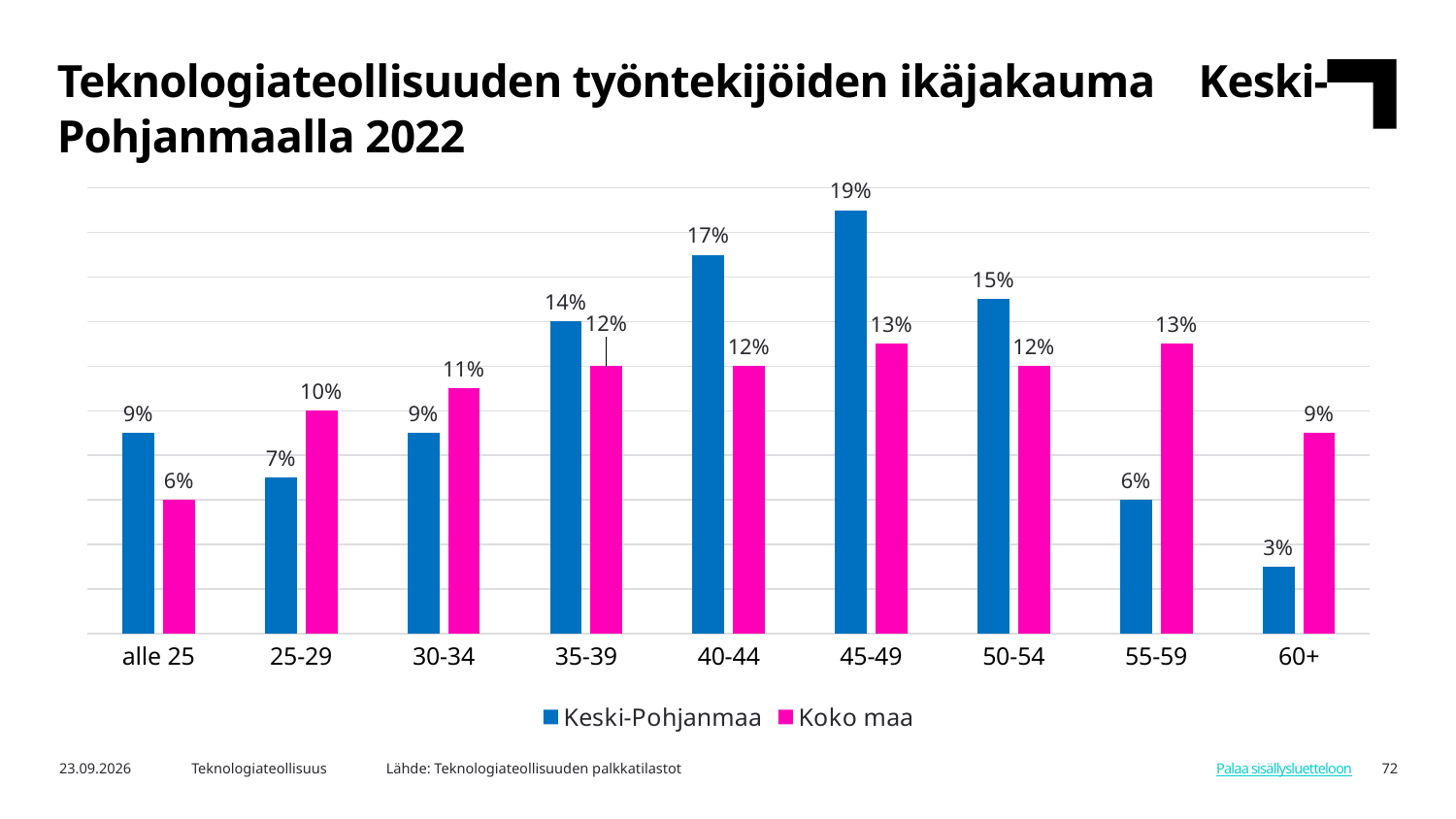
Which colour represents the Koko maa series? pink Which is larger for the 55-59 age group, Keski-Pohjanmaa or Koko maa? Koko maa What is the Keski-Pohjanmaa value for the 60+ age group? 3% Which age group has the lowest Koko maa value? alle 25 Which age group has the highest Keski-Pohjanmaa value? 45-49 What is the Keski-Pohjanmaa value for the 45-49 age group? 19% Do the Keski-Pohjanmaa values rise or fall from the 45-49 age group to the 60+ age group? fall What is the difference between the Keski-Pohjanmaa and Koko maa values for the 40-44 age group? 5% What kind of chart is shown on the slide? bar chart How many series does the legend list? 2 How many age groups are shown on the x axis? 9 What is the Koko maa value for the 30-34 age group? 11%